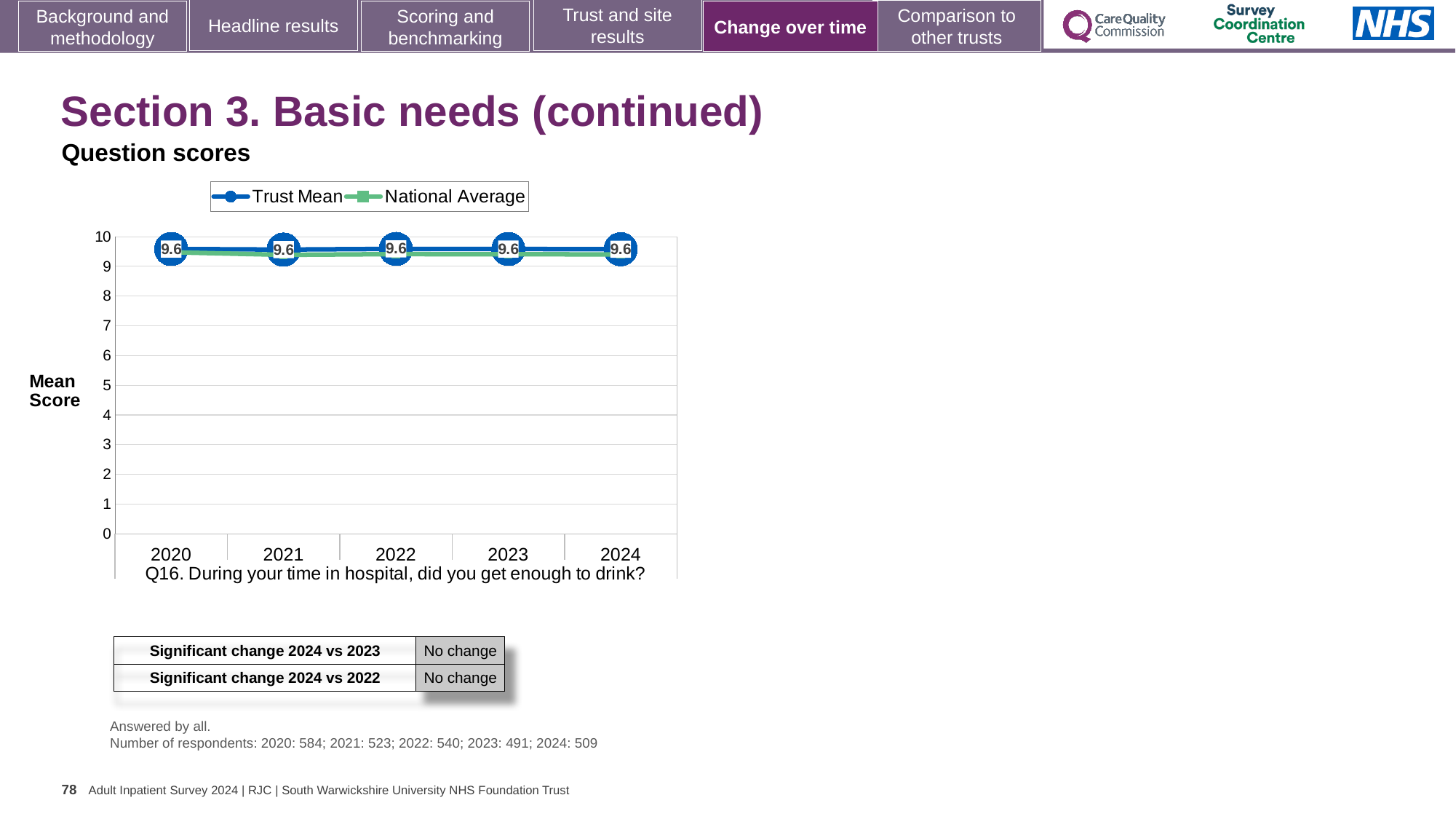
Does the Trust Mean rise, fall or stay the same from 2020 to 2024? Stays the same How many years are plotted on the x axis? 5 How many series does the legend list? 2 Is the Trust Mean value for 2023 greater or less than 5? greater What is the label on the y axis of the chart? Mean Score What kind of chart is shown on the slide? Line chart Which question does the chart show scores for? Q16. During your time in hospital, did you get enough to drink? Is the National Average value for 2021 greater or less than 9? greater What is the difference between the Trust Mean in 2024 and the Trust Mean in 2020? 0 What is the Trust Mean value for 2024? 9.6 What is the Trust Mean value for 2020? 9.6 What is the Trust Mean value for 2022? 9.6